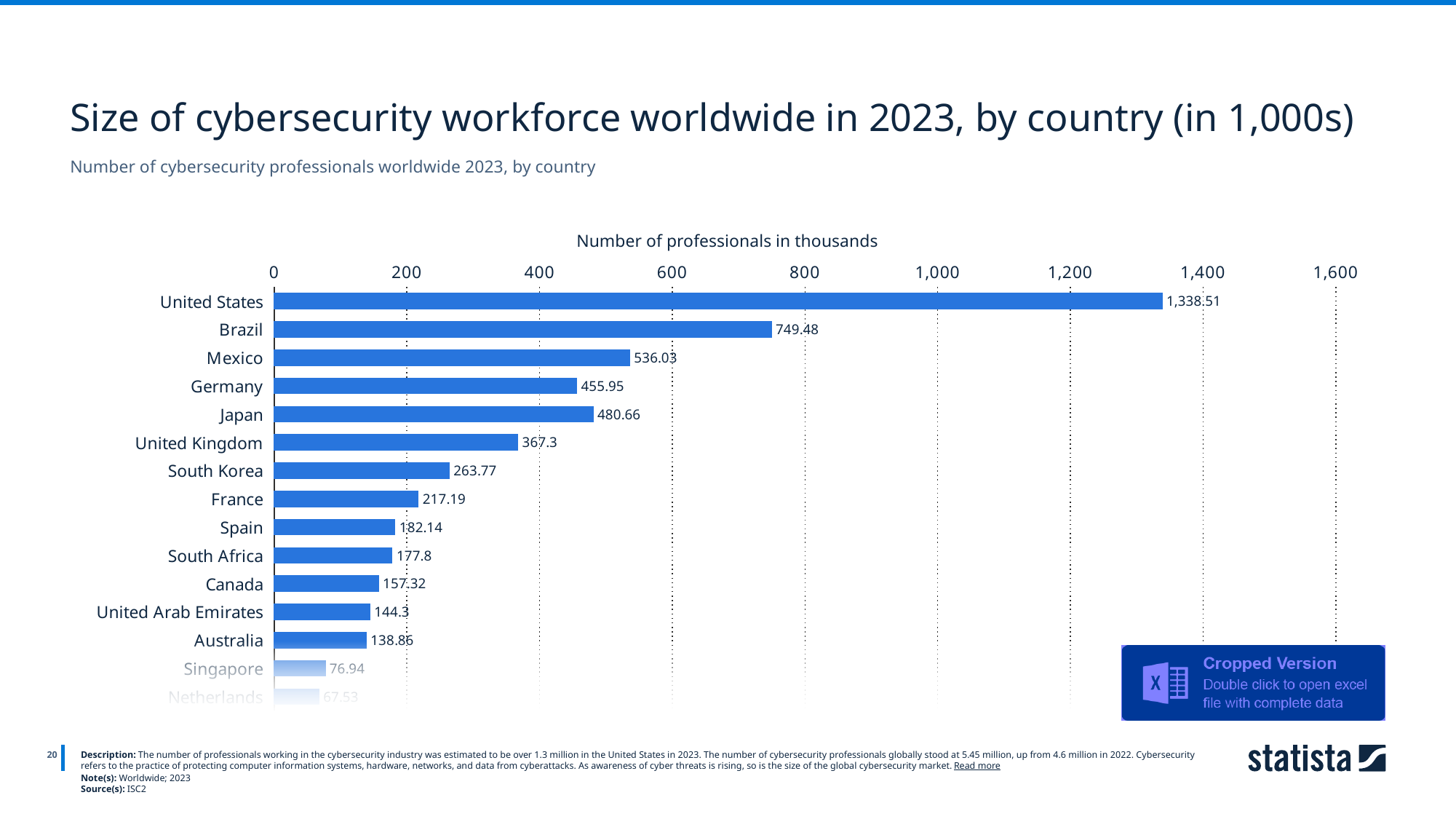
What is the difference between the values for Japan and Germany? 24.71 What is the value for Canada? 157.32 What is the title of the horizontal axis? Number of professionals in thousands Which country has the highest value? United States What is the value for Brazil? 749.48 What kind of chart is shown on the slide? bar chart What is the difference between the values for Brazil and Mexico? 213.45 Which has a larger value, Japan or Germany? Japan Is the value for Mexico greater or less than 600? less Which has a larger value, South Korea or France? South Korea What is the value for the United Kingdom? 367.3 What is the value for the United States? 1,338.51